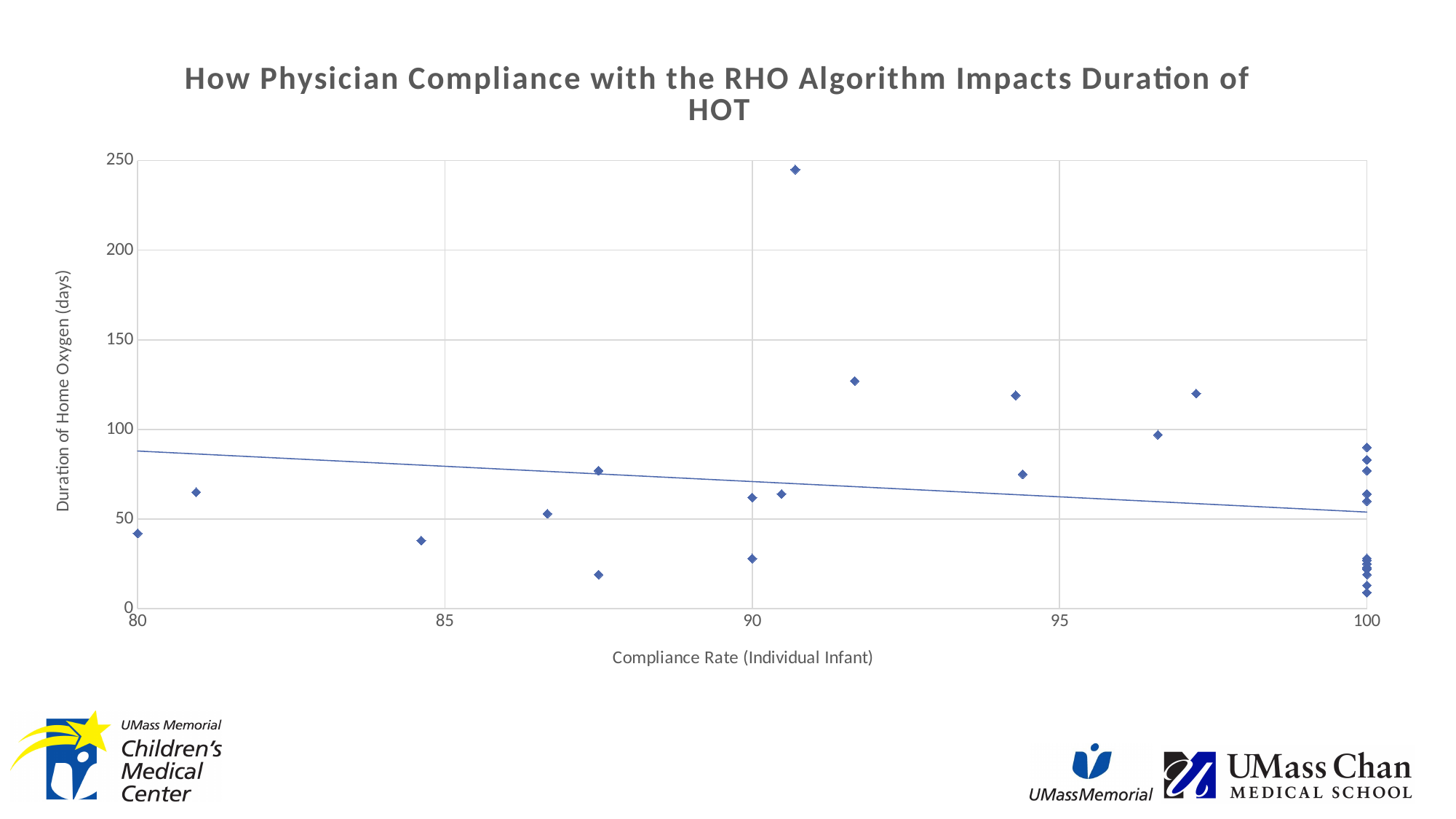
Is the duration for the point at a compliance rate of about 91.7 greater or less than 100 days? greater Which has the longer duration of home oxygen: the point at a compliance rate of about 81 or the point at about 84.6? the point at about 81 Is the duration for the lowest point on the chart greater or less than 50 days? less Is the duration for the highest point on the chart greater or less than 200 days? greater Does the trend line rise or fall as the compliance rate increases along the x axis? falls What is the title of the chart? How Physician Compliance with the RHO Algorithm Impacts Duration of HOT Which has the longer duration of home oxygen: the highest point near a compliance rate of 90.7 or the point at a compliance rate of 80? the point near 90.7 What is the label of the vertical axis of the chart? Duration of Home Oxygen (days) What kind of chart is shown on the slide? scatter chart